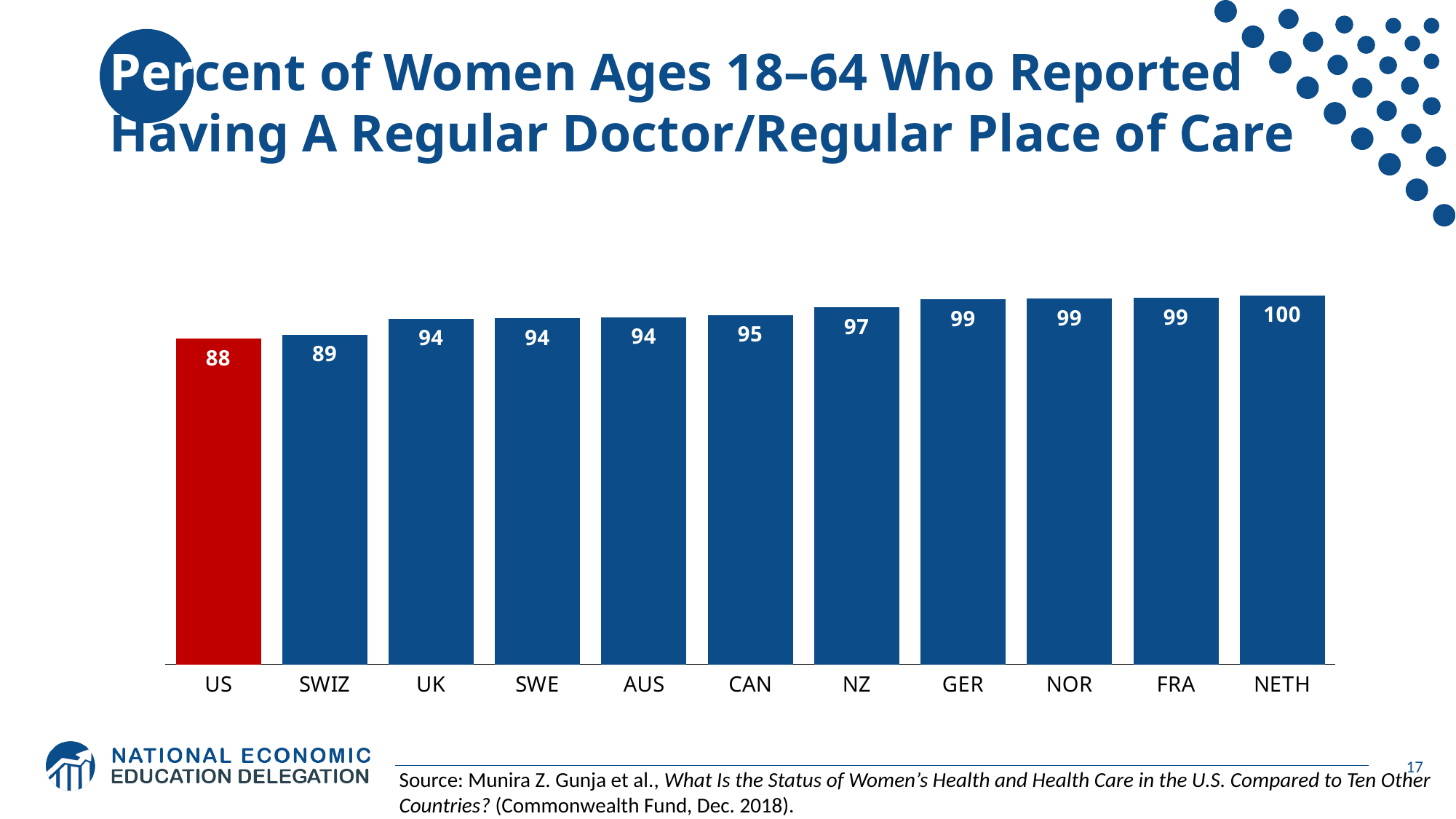
Do the values rise or fall from left to right along the x axis? rise Which country has the highest value? NETH Which country has the lowest value? US Which country's bar is coloured red? US What is the value for NZ? 97 Which has a larger value, UK or NZ? NZ What is the difference between the values for SWIZ and the US? 1 How many countries are shown in the chart? 11 What is the value for CAN? 95 What is the difference between the values for NETH and the US? 12 What is the value for the US? 88 What kind of chart is shown on the slide? bar chart